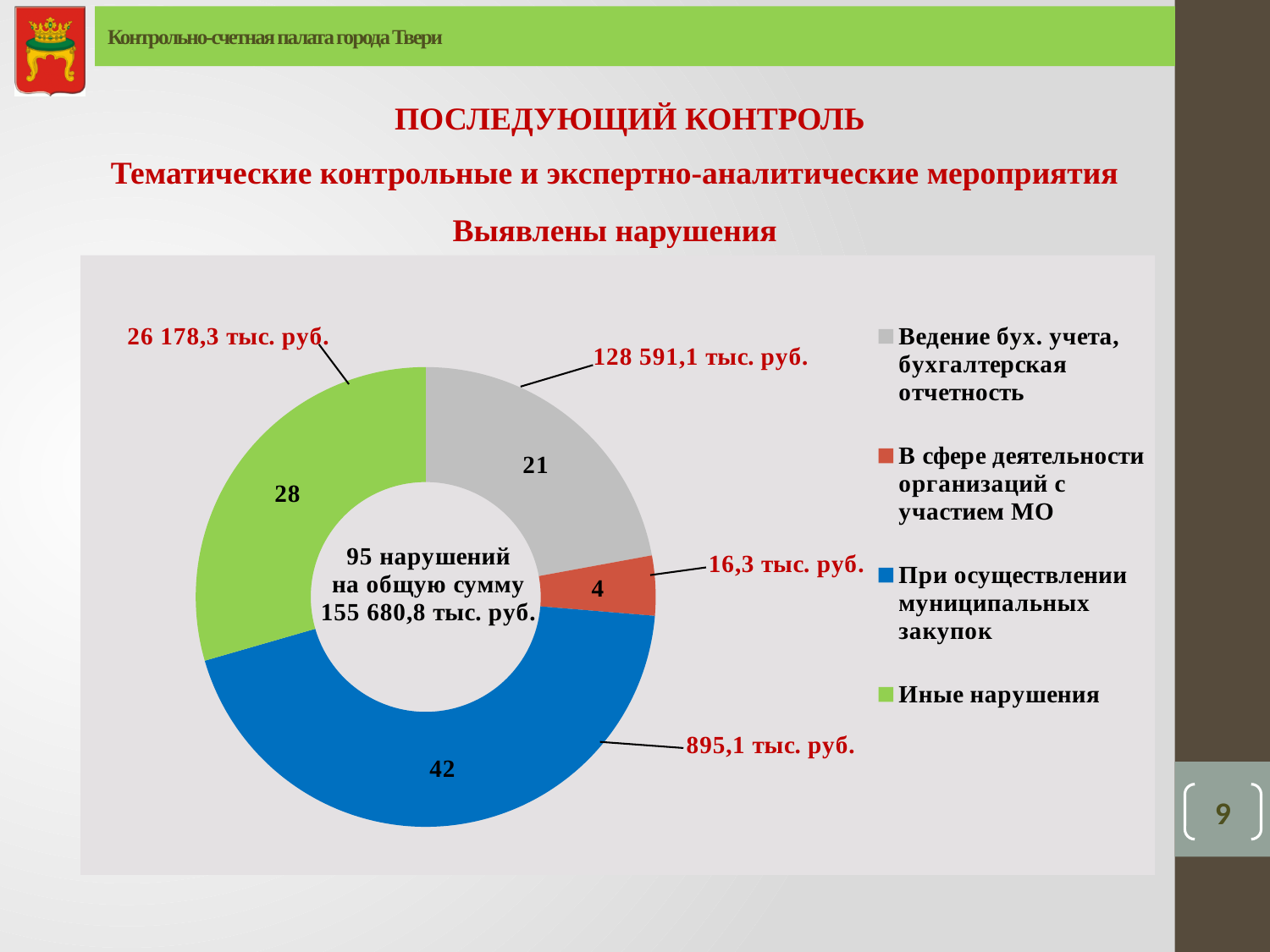
Which category has the smallest number of violations? В сфере деятельности организаций с участием МО What is the difference in the number of violations between "При осуществлении муниципальных закупок" and "Иные нарушения"? 14 How many categories does the legend list? 4 What amount in тыс. руб. is labelled for "В сфере деятельности организаций с участием МО"? 16,3 тыс. руб. Which colour represents "Иные нарушения" in the chart? Green What kind of chart is shown on the slide? Doughnut (pie) chart How many violations are shown for "Иные нарушения"? 28 What amount in тыс. руб. is labelled for "Ведение бух. учета, бухгалтерская отчетность"? 128 591,1 тыс. руб. How many violations are shown for "Ведение бух. учета, бухгалтерская отчетность"? 21 What total number of violations is stated in the centre of the chart? 95 нарушений Which category has the largest number of violations? При осуществлении муниципальных закупок How many violations are shown for "При осуществлении муниципальных закупок"? 42